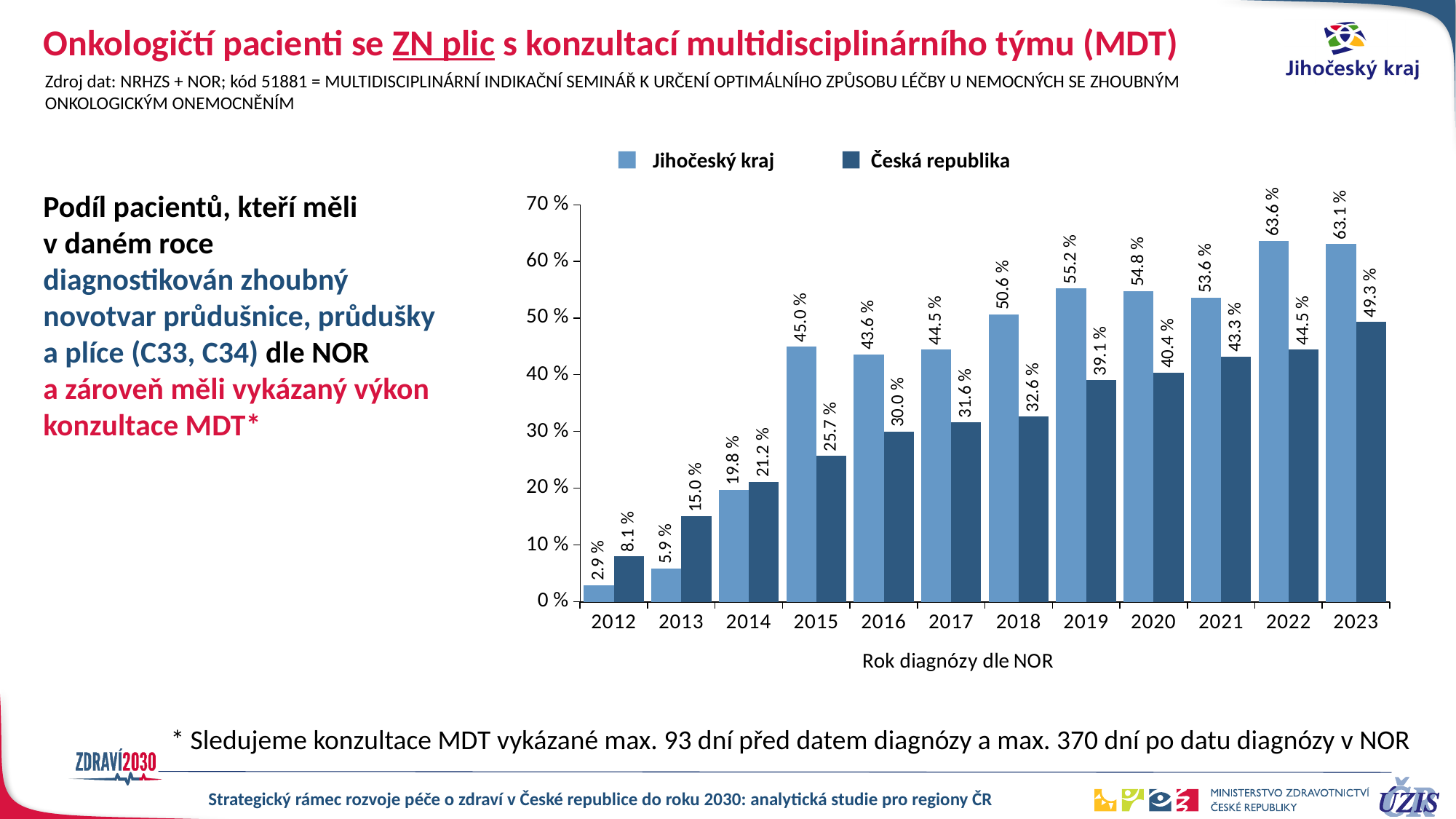
How many series does the legend list? 2 What is the value for Jihočeský kraj in 2015? 45.0 % What is the difference between the Jihočeský kraj and Česká republika values in 2022? 19.1 % What is the value for Jihočeský kraj in 2012? 2.9 % Does the Česká republika value rise or fall from 2012 to 2023? rise What is the value for Česká republika in 2023? 49.3 % What kind of chart is shown on the slide? bar chart Is the value for Jihočeský kraj in 2018 greater or less than 40 %? greater In which year is the Jihočeský kraj value highest? 2022 In which year is the Česká republika value lowest? 2012 Which is larger in 2013, the value for Jihočeský kraj or for Česká republika? Česká republika How many years are shown on the x axis? 12